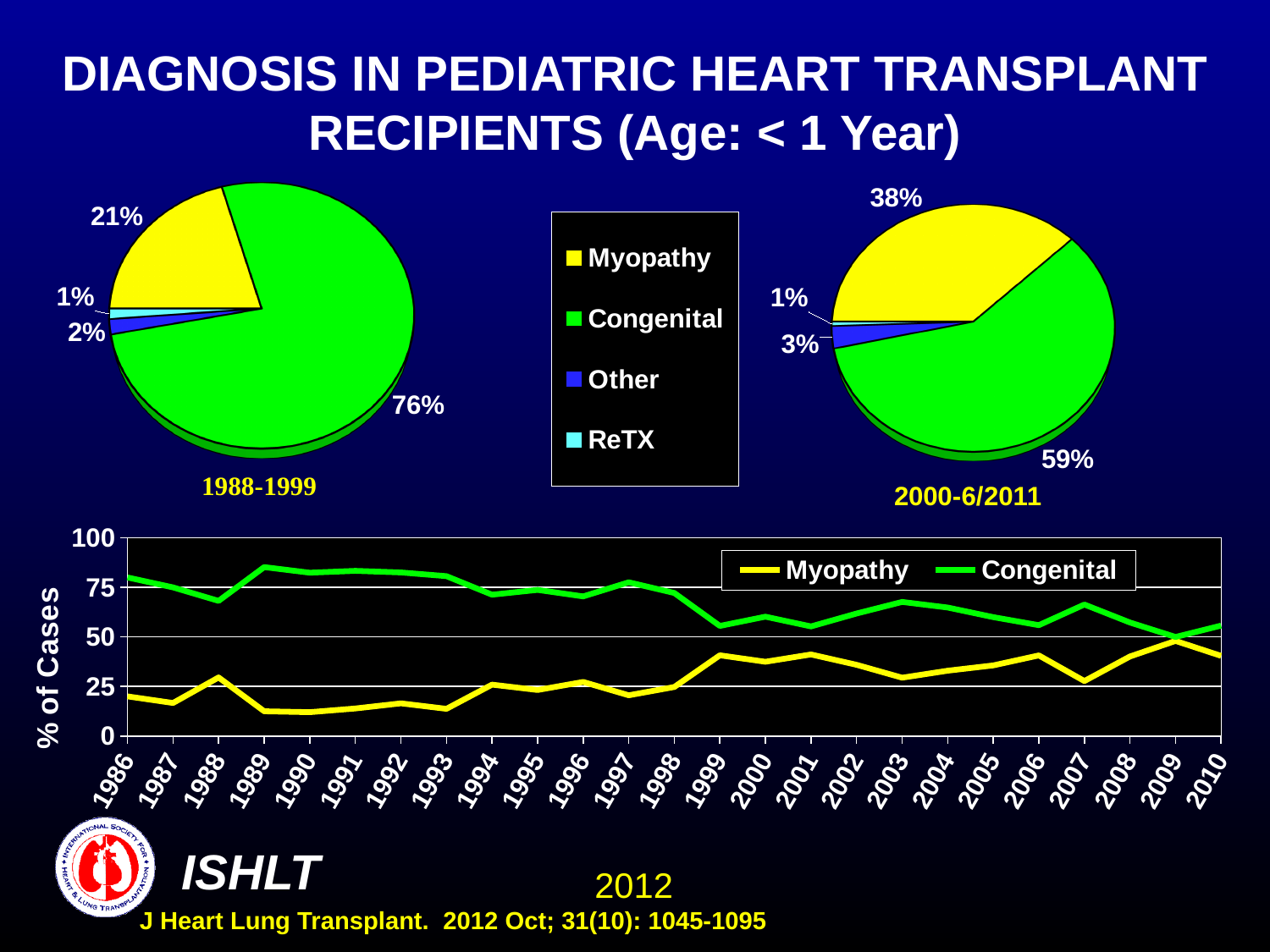
In the line chart at the bottom, how many series does the legend list? 2 What is the difference between the Congenital share in the 1988-1999 pie chart and the Congenital share in the 2000-6/2011 pie chart? 17% How many categories does the pie chart legend list? 4 In the 1988-1999 pie chart, what share of cases is Myopathy? 21% In the 2000-6/2011 pie chart, which diagnosis has the largest share? Congenital In the line chart at the bottom, is the Congenital value for 1989 greater or less than 75? greater In the line chart at the bottom, is the Myopathy value for 1990 greater or less than 25? less In the line chart at the bottom, does the Myopathy series generally rise or fall from 1986 to 2010? rise In the 2000-6/2011 pie chart, what share of cases is Myopathy? 38% In the 2000-6/2011 pie chart, what share of cases is Other? 3% In the 1988-1999 pie chart, what share of cases is Congenital? 76% In the 1988-1999 pie chart, which diagnosis has the smallest share? ReTX